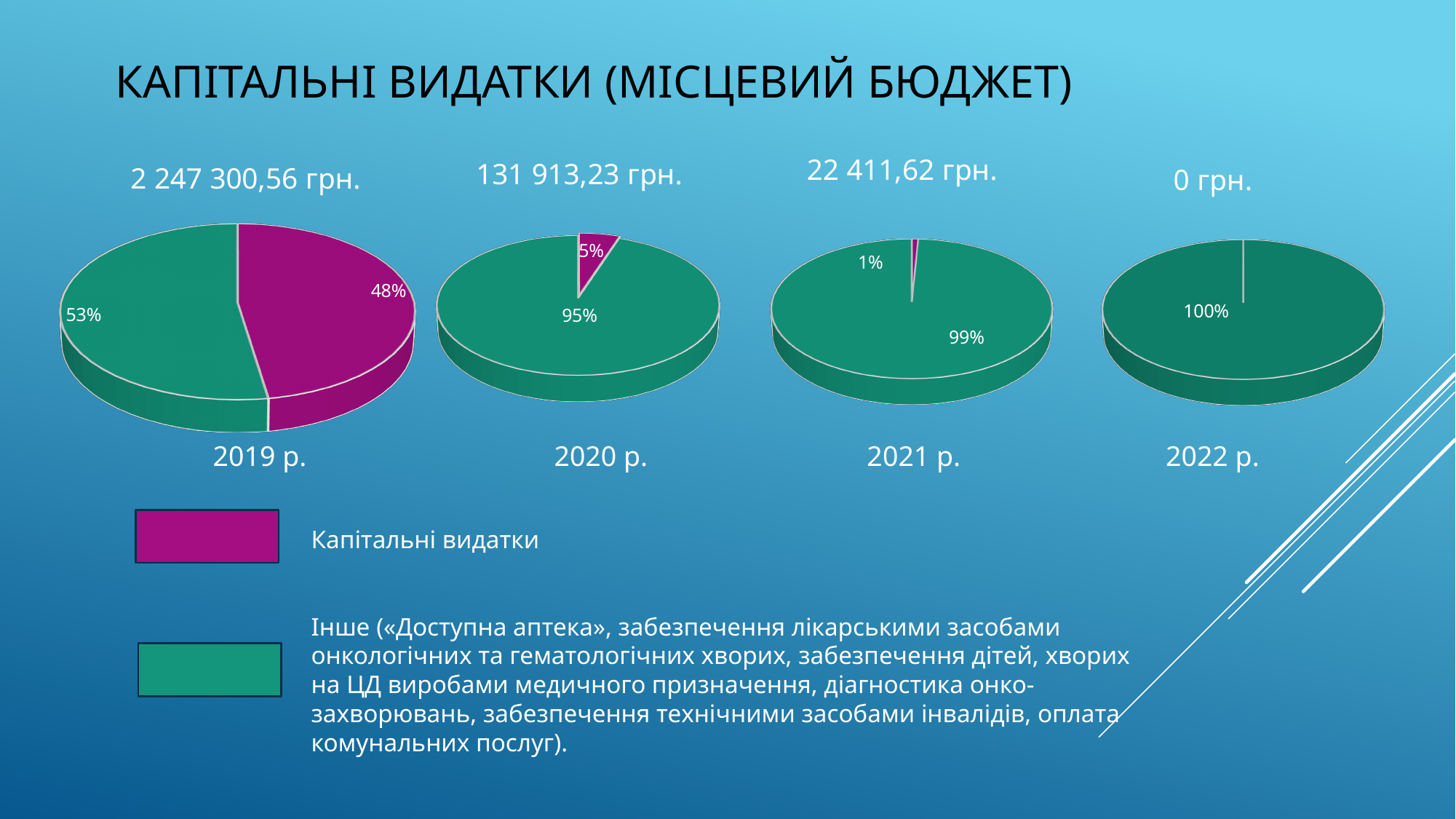
Which colour represents Капітальні видатки in the legend? Magenta In the 2019 р. pie chart, what share does Інше have? 53% In the 2022 р. pie chart, what share does Інше have? 100% In the 2020 р. pie chart, what share does Капітальні видатки have? 5% What amount is shown above the 2022 р. pie chart? 0 грн. What kind of charts are shown on the slide? Pie charts What amount is shown above the 2019 р. pie chart? 2 247 300,56 грн. What amount is shown above the 2021 р. pie chart? 22 411,62 грн. How many pie charts are on the slide? 4